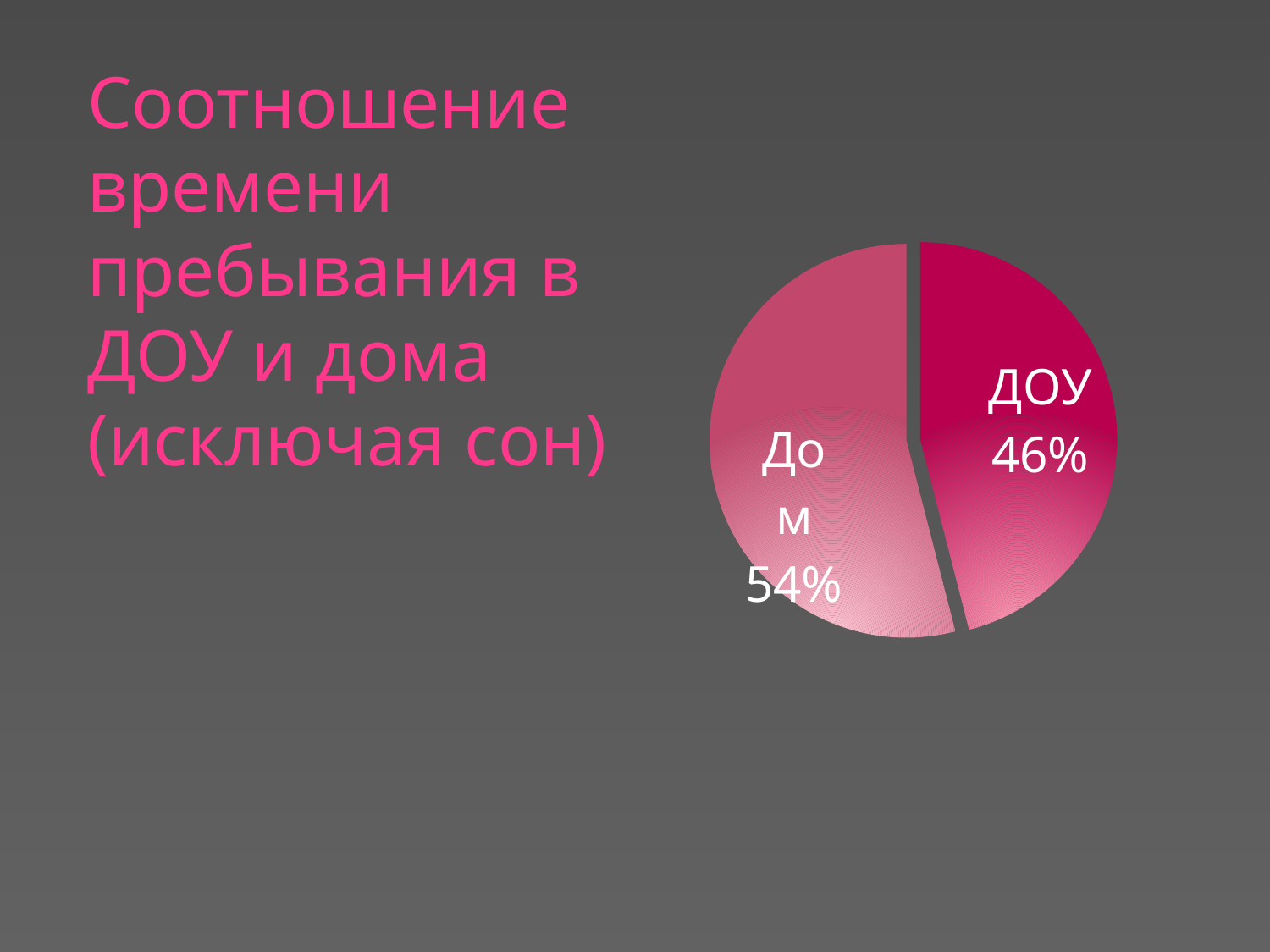
What share of the pie does the ДОУ slice represent? 46% What kind of chart is shown on the slide? pie chart Is the ДОУ slice greater or less than 50% of the pie? less Which slice of the pie is the largest? Дом How many slices does the pie chart have? 2 Which is larger, the ДОУ slice or the Дом slice? Дом What is the title of the slide containing the chart? Соотношение времени пребывания в ДОУ и дома (исключая сон) What is the difference in percentage points between the Дом slice and the ДОУ slice? 8 What percentage of the pie is labelled Дом? 54% Which slice of the pie is the smallest? ДОУ What percentage of the pie is labelled ДОУ? 46%